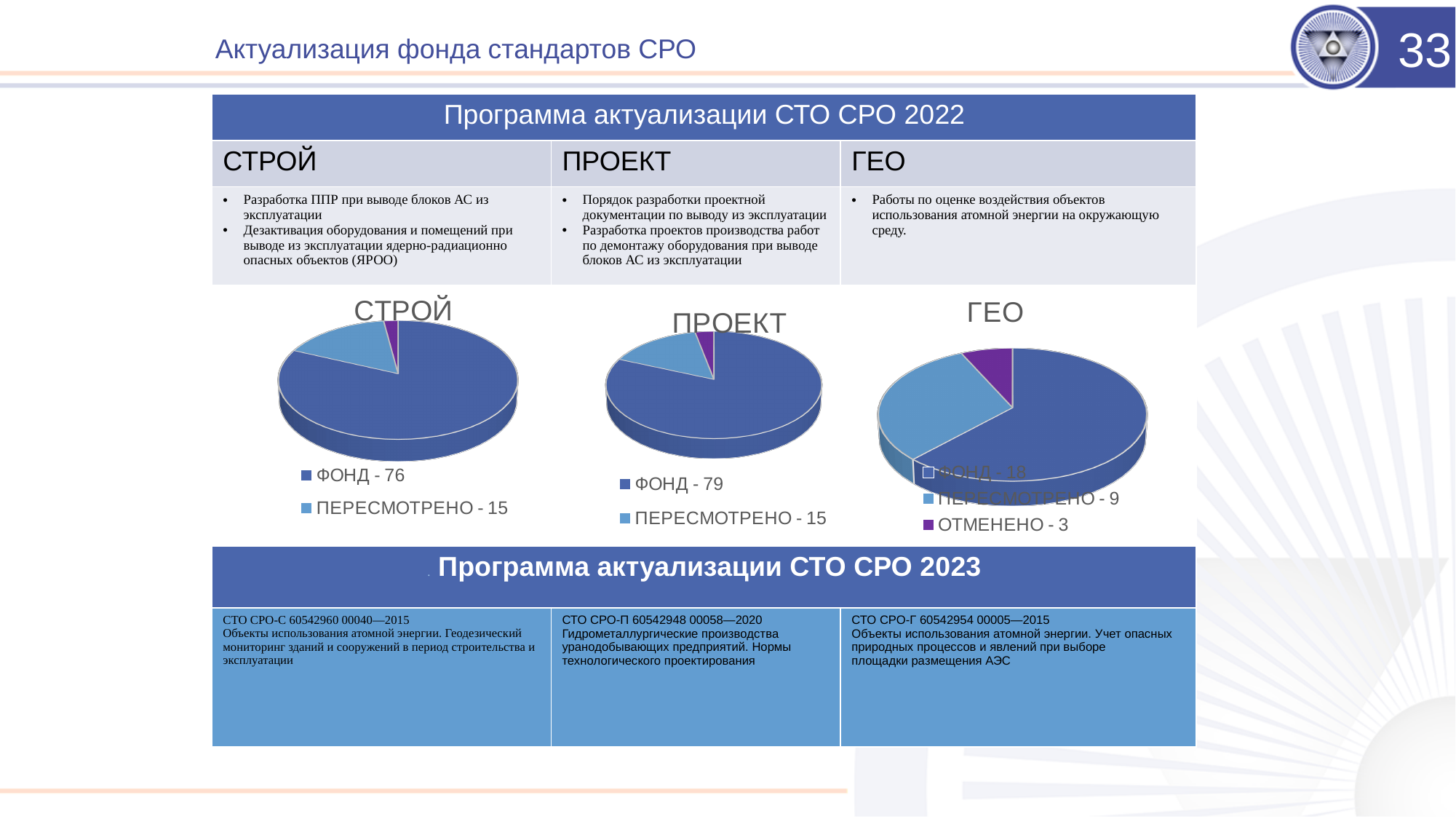
In the ГЕО pie chart, which category has the largest slice? ФОНД In the ГЕО pie chart, what share of the total do the ФОНД standards represent? 60% In the ПРОЕКТ pie chart, what is the difference between the ФОНД value and the ПЕРЕСМОТРЕНО value? 64 What type of chart is used for СТРОЙ, ПРОЕКТ and ГЕО? Pie chart Which is larger: the ФОНД value in the СТРОЙ chart or the ФОНД value in the ПРОЕКТ chart? ПРОЕКТ In the ГЕО pie chart, what is the total of the three listed values? 30 In the ГЕО pie chart, what value is given for ОТМЕНЕНО? 3 In the СТРОЙ pie chart, what is the difference between the ФОНД value and the ПЕРЕСМОТРЕНО value? 61 In the ПРОЕКТ pie chart, what value is given for ПЕРЕСМОТРЕНО? 15 In the ГЕО pie chart, which category has the smallest slice? ОТМЕНЕНО How many entries does the legend of the ГЕО chart list? 3 In the СТРОЙ pie chart, what value is given for ФОНД? 76